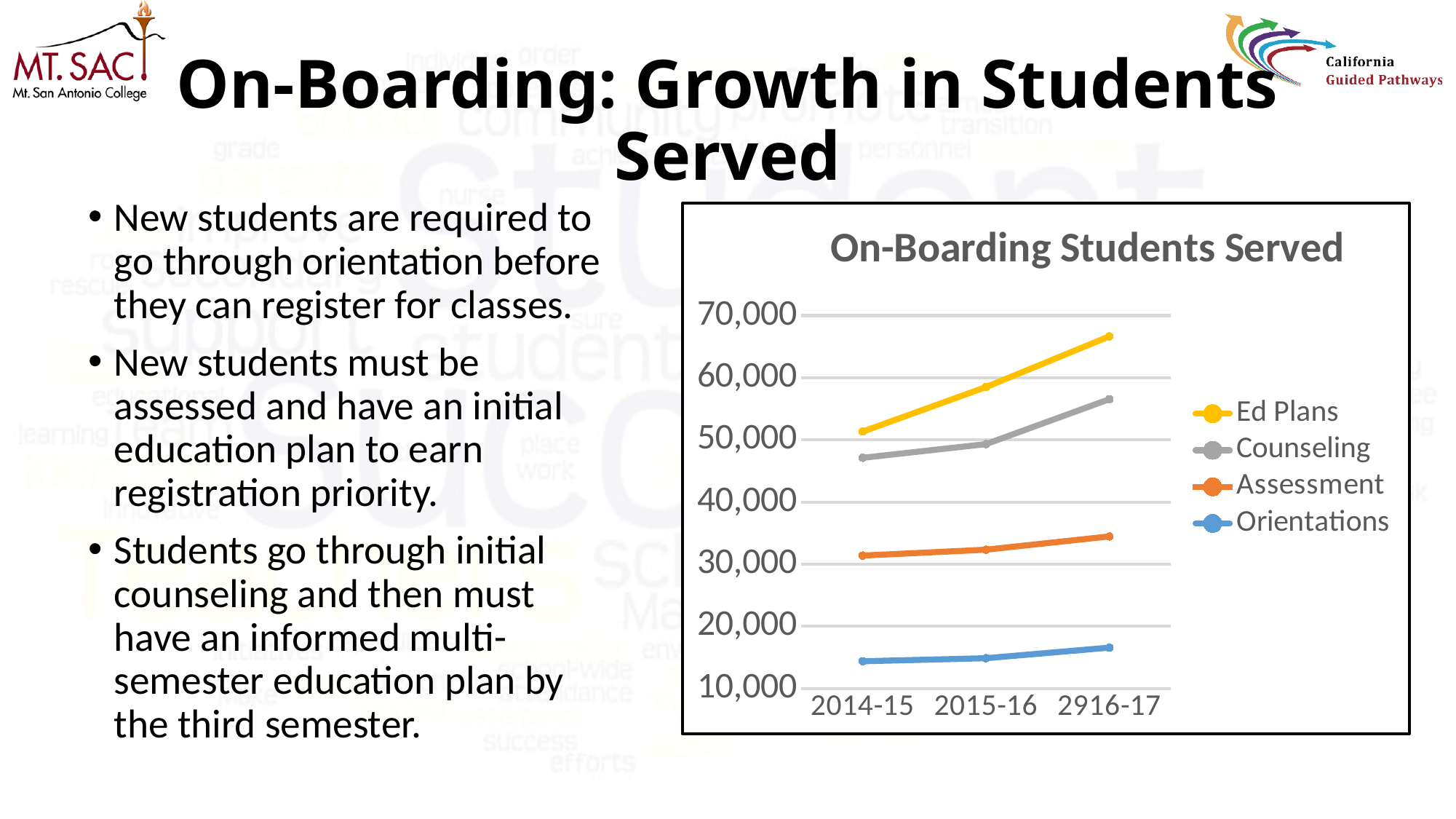
How many time periods are shown along the x axis of the chart? 3 In 2016-17, which is larger: Ed Plans or Counseling? Ed Plans Which series has the lowest values across all periods in the chart? Orientations Is the value for Counseling in 2014-15 greater or less than 50,000? less In 2015-16, which is larger: Assessment or Orientations? Assessment Which series has the highest values across all periods in the chart? Ed Plans Do the Ed Plans values rise or fall from 2014-15 to 2016-17? Rise What is the title of the chart? On-Boarding Students Served What kind of chart is shown on the slide? Line chart How many series does the legend of the chart list? 4 Is the value for Orientations in 2014-15 greater or less than 20,000? less Is the value for Ed Plans in 2016-17 greater or less than 60,000? greater